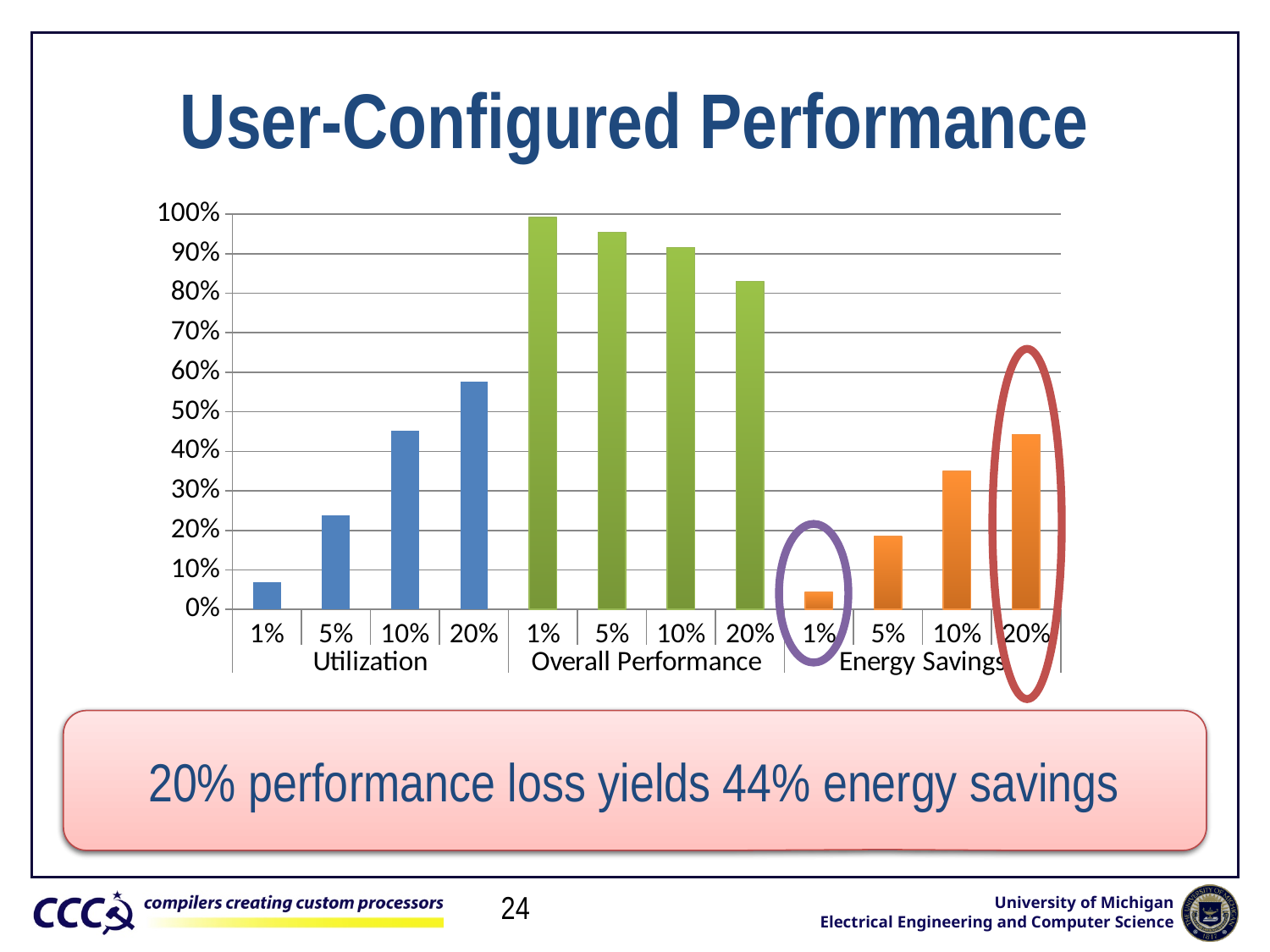
Which bar is the tallest in the chart? Overall Performance at 1% Do the Overall Performance bars rise or fall as the setting goes from 1% to 20%? fall Do the Energy Savings bars rise or fall as the setting goes from 1% to 20%? rise How many bars are plotted in the chart? 12 Which is larger, the Utilization value at 10% or the Energy Savings value at 5%? Utilization at 10% Is the Energy Savings value at 10% greater or less than 30%? greater Is the Overall Performance value at 20% greater or less than 90%? less Is the Utilization value at 1% greater or less than 10%? less Which bar is the shortest in the chart? Energy Savings at 1% What are the three category groups along the x axis? Utilization, Overall Performance, Energy Savings What kind of chart is shown on the slide? bar chart